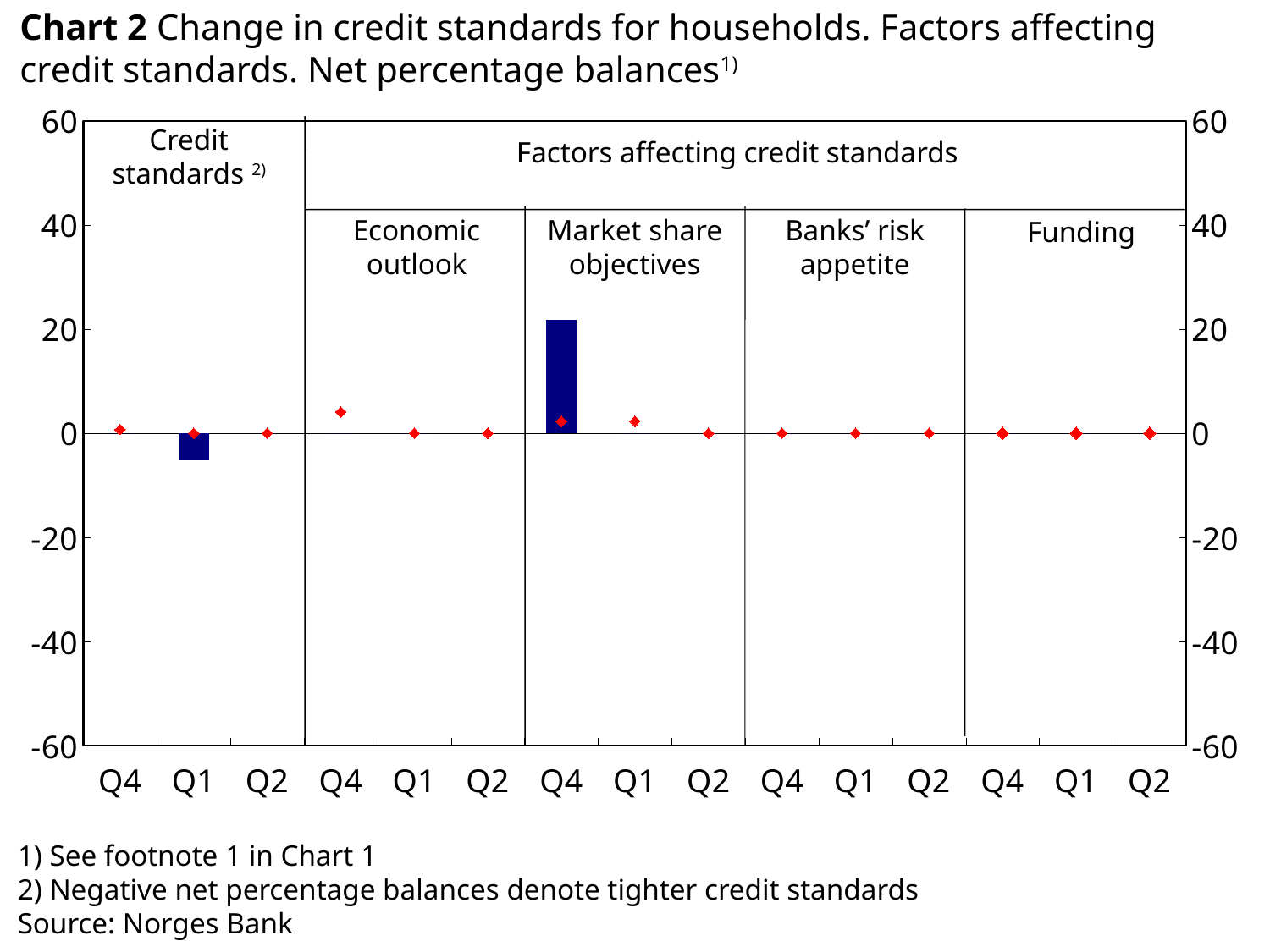
Is the bar for Q1 in the Credit standards panel greater or less than 0? less What is the highest value shown on the y axis of the chart? 60 Is the bar for Q4 in the Market share objectives panel greater or less than 0? greater Which panel contains the tallest bar in the chart? Market share objectives What kind of chart is shown on the slide? combination bar and line chart (bars with diamond markers) Is the bar for Q4 in the Market share objectives panel greater or less than 40? less Which quarter in the Credit standards panel has a bar below zero? Q1 How many factors affecting credit standards are shown as separate panels in the chart? 4 How many quarters are labelled on the x axis within each panel of the chart? 3 Which is larger: the bar for Q4 in the Market share objectives panel or the bar for Q1 in the Credit standards panel? Q4 in Market share objectives What is the source given for the chart? Norges Bank